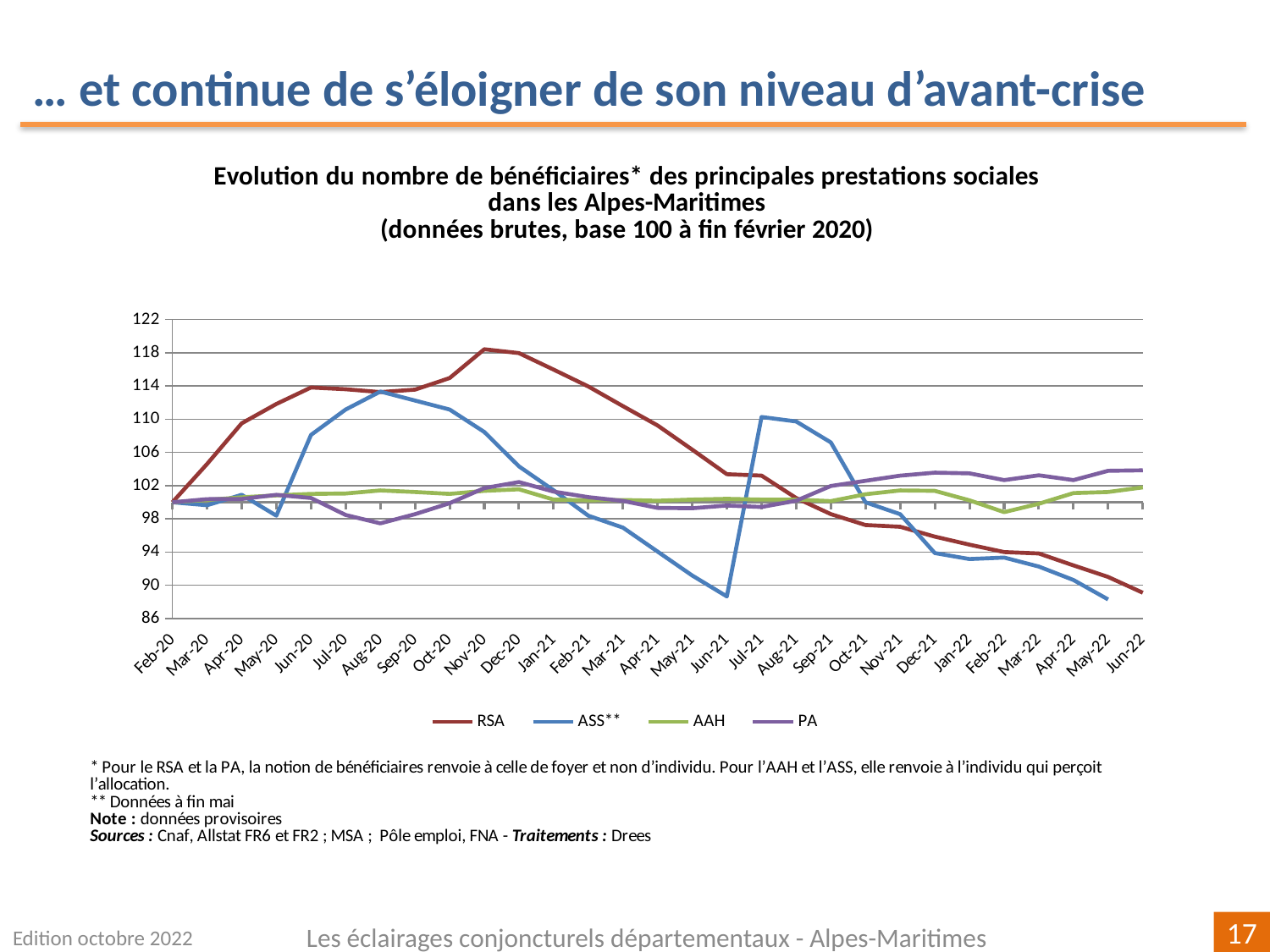
In Nov-20, which is larger, the value for RSA or the value for ASS**? RSA Is the value for ASS** in Jul-21 greater or less than 106? greater What kind of chart is shown on the slide? line chart Is the value for ASS** in Jun-21 greater or less than 90? less Is the value for RSA in Nov-20 greater or less than 114? greater Which series are listed in the legend? RSA, ASS**, AAH, PA How many monthly points are plotted along the x axis, from Feb-20 to Jun-22? 29 Which series has the lowest value in Jun-21? ASS** How many series does the legend list? 4 Does the RSA line rise or fall between Nov-20 and Jun-22? fall